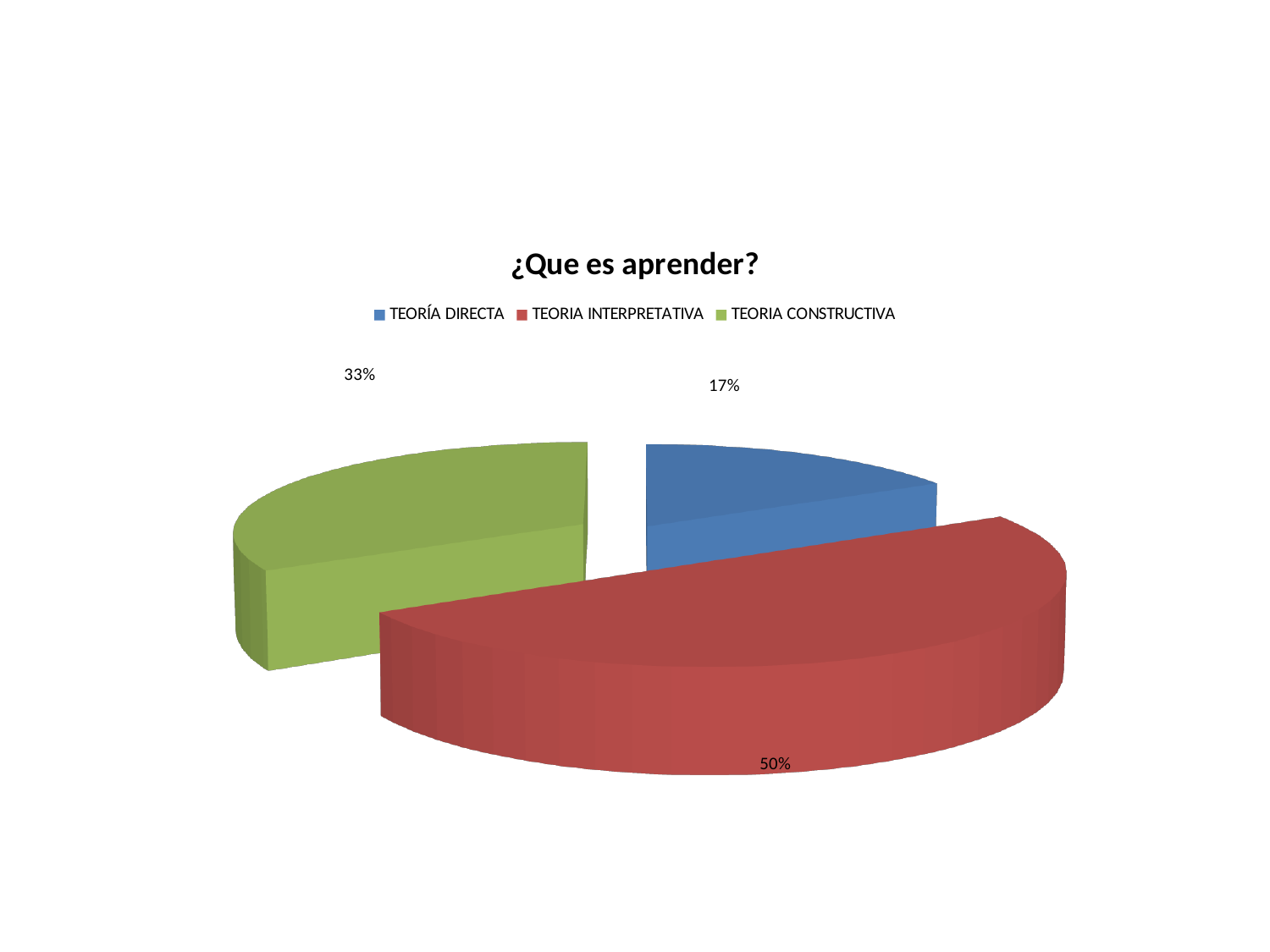
What percentage of the pie does TEORIA INTERPRETATIVA represent? 50% What is the difference in percentage points between TEORIA CONSTRUCTIVA and TEORÍA DIRECTA? 16 What kind of chart is shown on the slide? Pie chart What percentage of the pie does TEORIA CONSTRUCTIVA represent? 33% Which is larger, the slice for TEORIA CONSTRUCTIVA or the slice for TEORÍA DIRECTA? TEORIA CONSTRUCTIVA Which category has the smallest slice of the pie? TEORÍA DIRECTA How many slices does the pie chart have? 3 Which category has the largest slice of the pie? TEORIA INTERPRETATIVA What is the difference in percentage points between TEORIA INTERPRETATIVA and TEORÍA DIRECTA? 33 Which colour represents TEORIA CONSTRUCTIVA in the chart? Green What is the title of the chart? ¿Que es aprender? What percentage of the pie does TEORÍA DIRECTA represent? 17%